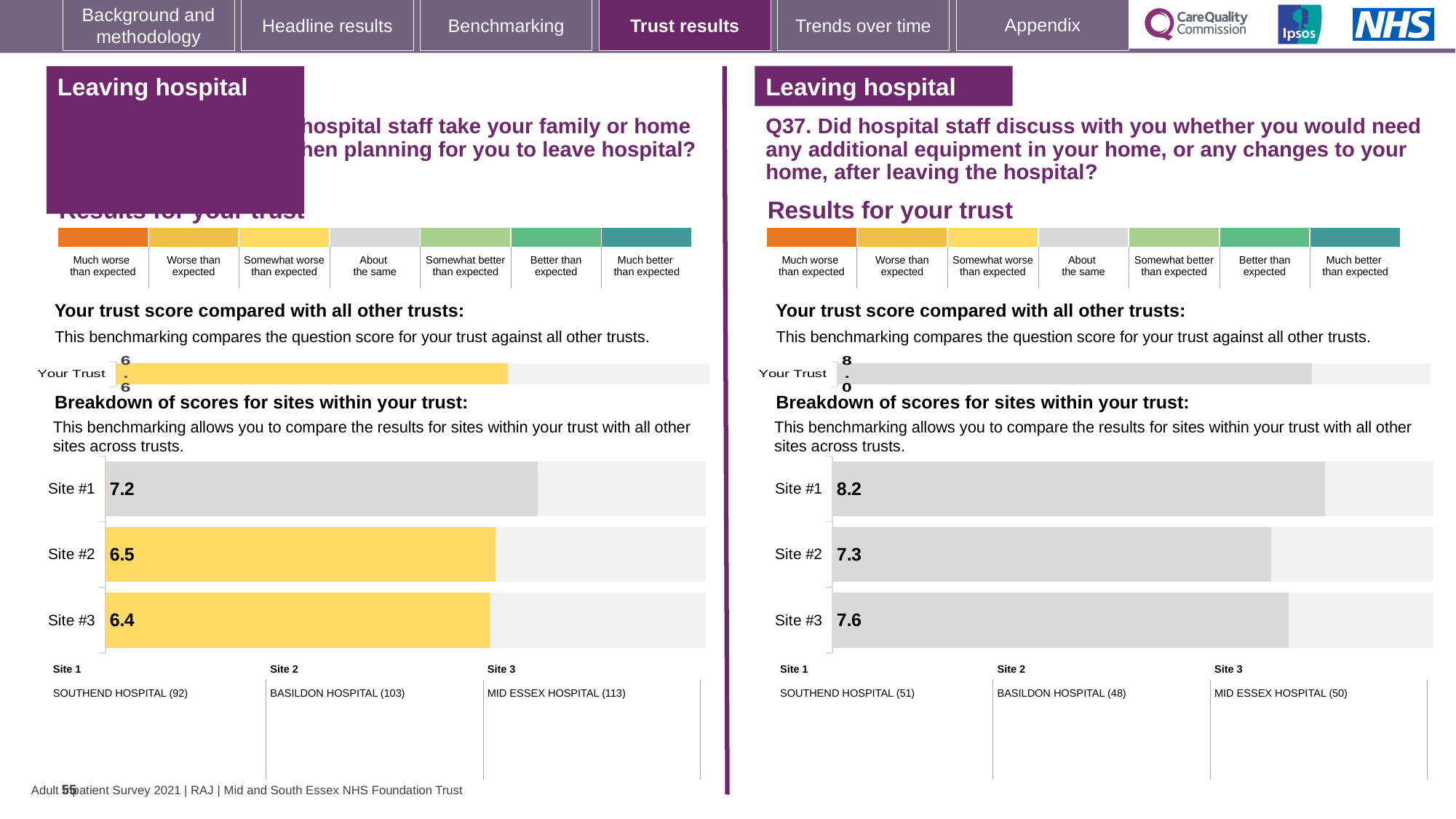
On the right-hand (Q37) site breakdown chart, which site has the lowest score? Site #2 On the right-hand (Q37) site breakdown chart, what is the score for Site #1? 8.2 On the left-hand site breakdown chart, which site has the highest score? Site #1 On the left-hand site breakdown chart, what is the score for Site #2? 6.5 How many sites are shown in the left-hand site breakdown chart? 3 On the left-hand 'Your trust score compared with all other trusts' chart, what is the score for Your Trust? 6.6 On the right-hand (Q37) 'Your trust score compared with all other trusts' chart, what is the score for Your Trust? 8.0 What type of chart is used for the breakdown of scores for sites within your trust on the right-hand side? Bar chart On the left-hand site breakdown chart, what colour are the bars for Site #2 and Site #3? Yellow On the left-hand site breakdown chart, what is the difference between the scores for Site #1 and Site #3? 0.8 On the right-hand (Q37) site breakdown chart, what is the difference between the scores for Site #1 and Site #2? 0.9 On the right-hand (Q37) site breakdown chart, which has the larger score, Site #2 or Site #3? Site #3